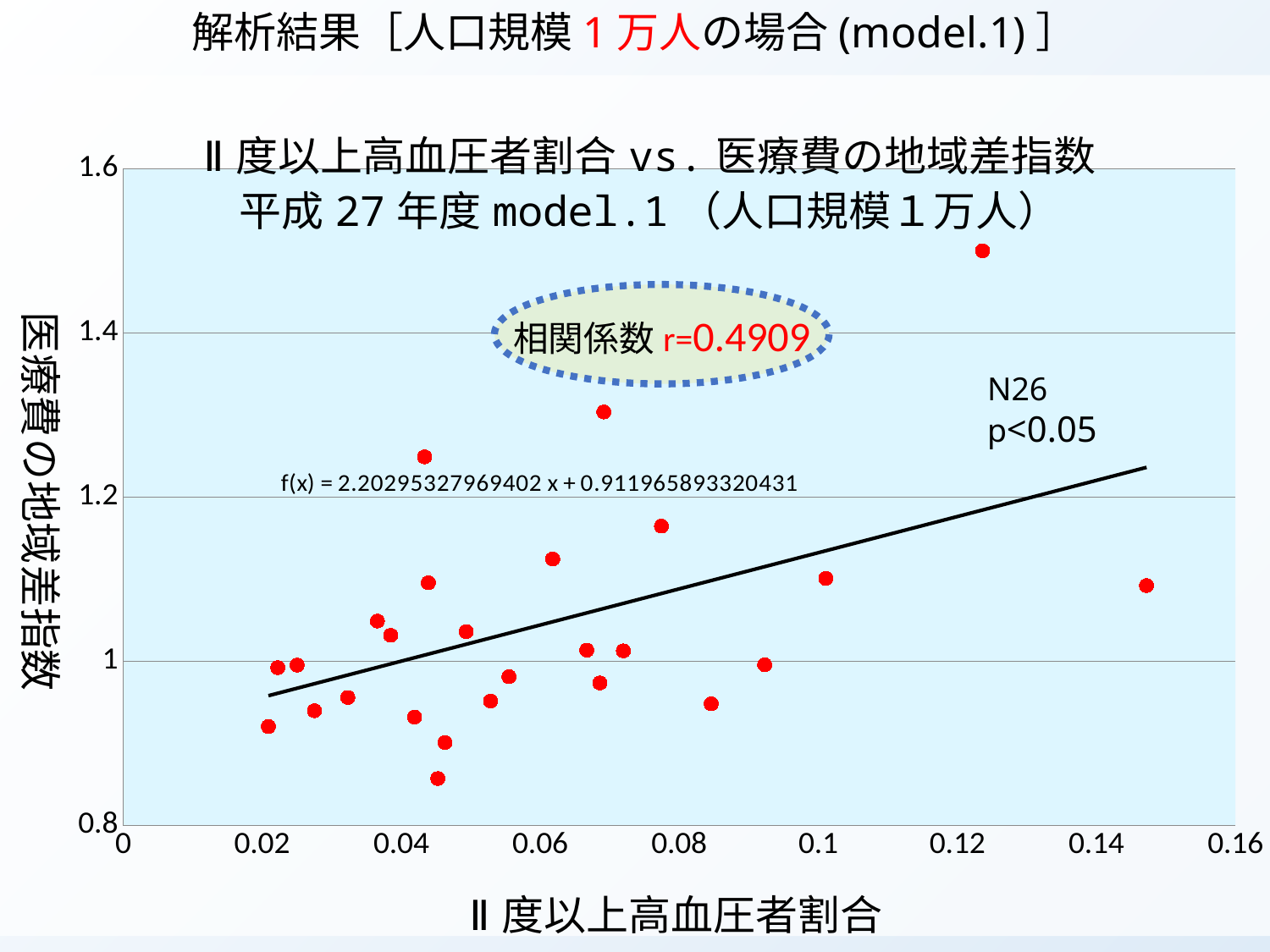
How many data points are plotted on the chart? 26 What is the maximum value shown on the x axis? 0.16 Is the x value of the rightmost plotted point greater or less than 0.14? greater Is the y value of the highest plotted point greater or less than 1.4? greater Is the y value of the lowest plotted point greater or less than 0.9? less What kind of chart is shown on the slide? scatter plot What sample size (N) is stated on the chart? N26 What is the slope of the fitted line f(x) shown on the chart? 2.20295327969402 What is the intercept of the fitted line f(x) shown on the chart? 0.911965893320431 What is the correlation coefficient (相関係数) shown on the chart? r=0.4909 Does the fitted trend line rise or fall as the x-axis value (Ⅱ度以上高血圧者割合) increases? rise What p-value condition is stated on the chart? p<0.05